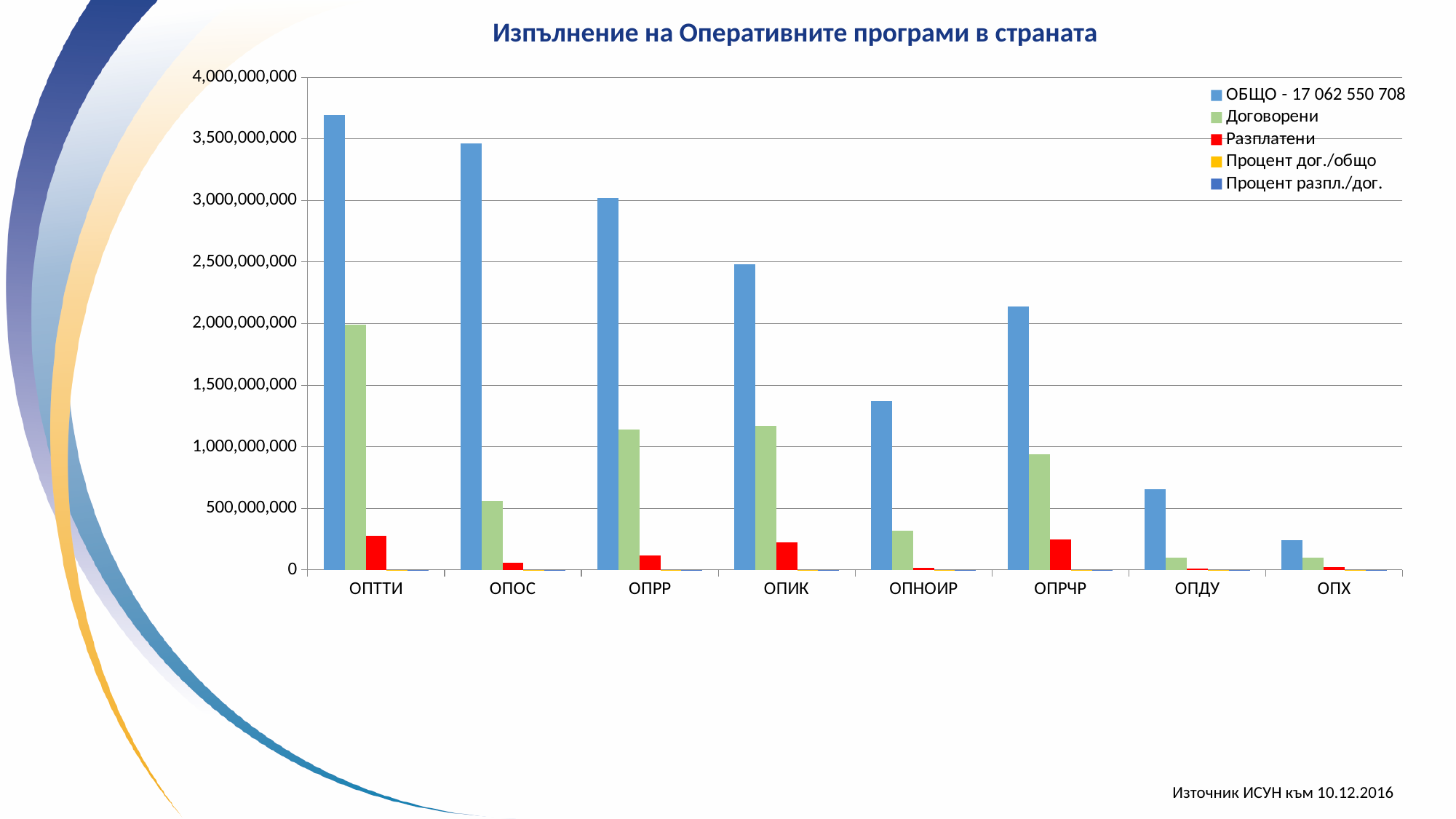
Which has the larger ОБЩО value, ОПОС or ОПРР? ОПОС Which programme has the highest Договорени value? ОПТТИ Which has the larger Договорени value, ОПОС or ОПРЧР? ОПРЧР How many operational programmes (categories) are shown on the x axis? 8 Which programme has the lowest ОБЩО value? ОПХ What is the title of the chart? Изпълнение на Оперативните програми в страната How many series does the legend list? 5 What kind of chart is shown on the slide? bar chart Is the ОБЩО value for ОПТТИ greater or less than 3,500,000,000? greater Is the Договорени value for ОПРР greater or less than 1,000,000,000? greater Is the ОБЩО value for ОПНОИР greater or less than 1,500,000,000? less Which programme has the highest ОБЩО value? ОПТТИ